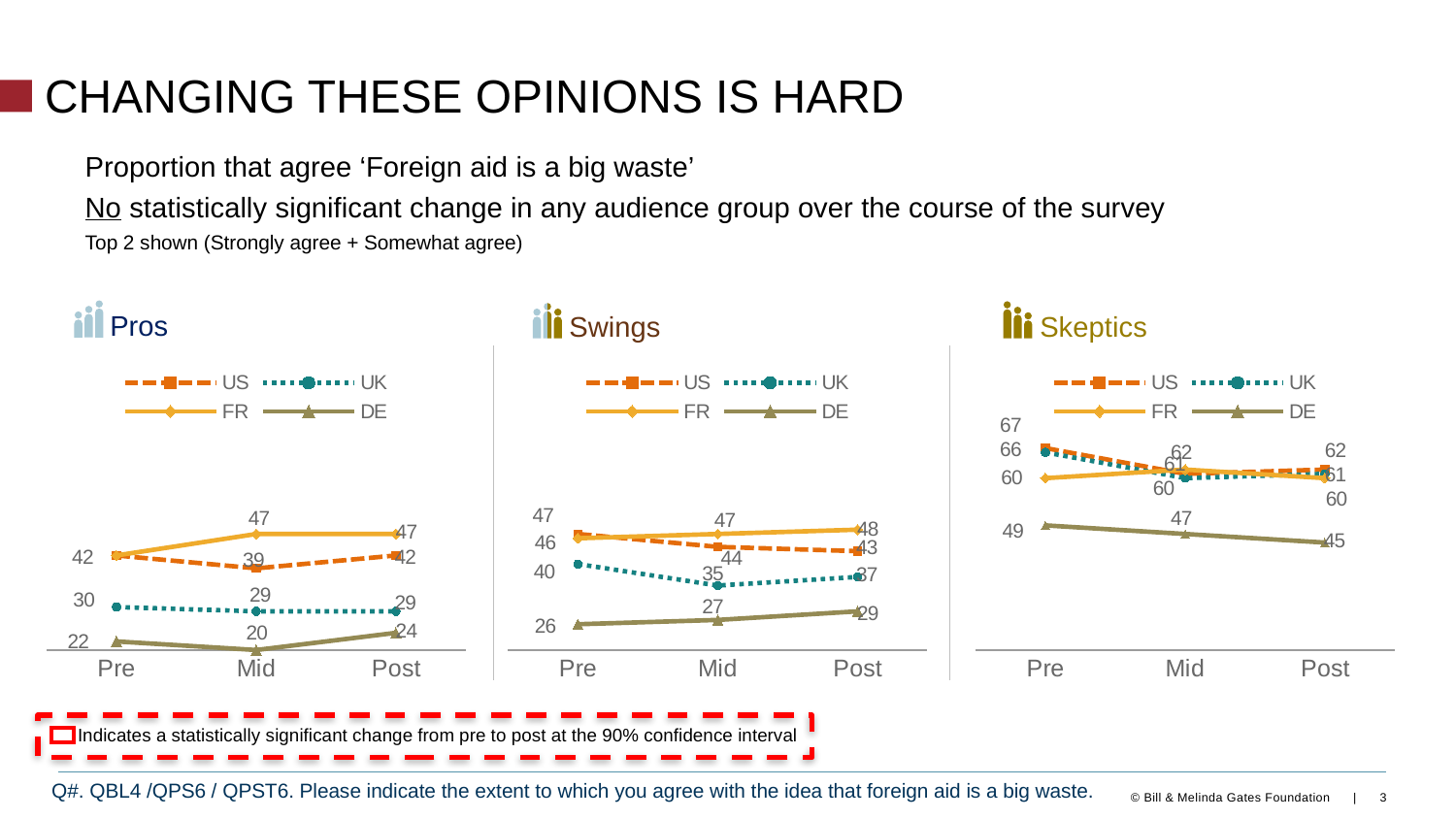
In the Pros chart, what is the value for FR at Post? 47 In the Swings chart, which is larger at Pre: US or UK? US What kind of chart is used for the Pros, Swings and Skeptics panels? Line chart In the Pros chart, what is the value for DE at Mid? 20 How many time points are shown on the x axis of each chart? 3 In the Pros chart, what is the difference between FR and US at Mid? 8 In the Swings chart, which series has the highest value at Post? FR In the Swings chart, what is the value for UK at Mid? 35 In the Pros chart, which series has the lowest value at Pre? DE In the Swings chart, does the DE series rise or fall from Pre to Post? Rise In the Skeptics chart, what is the value for DE at Post? 45 How many series does the legend list in the Skeptics chart? 4